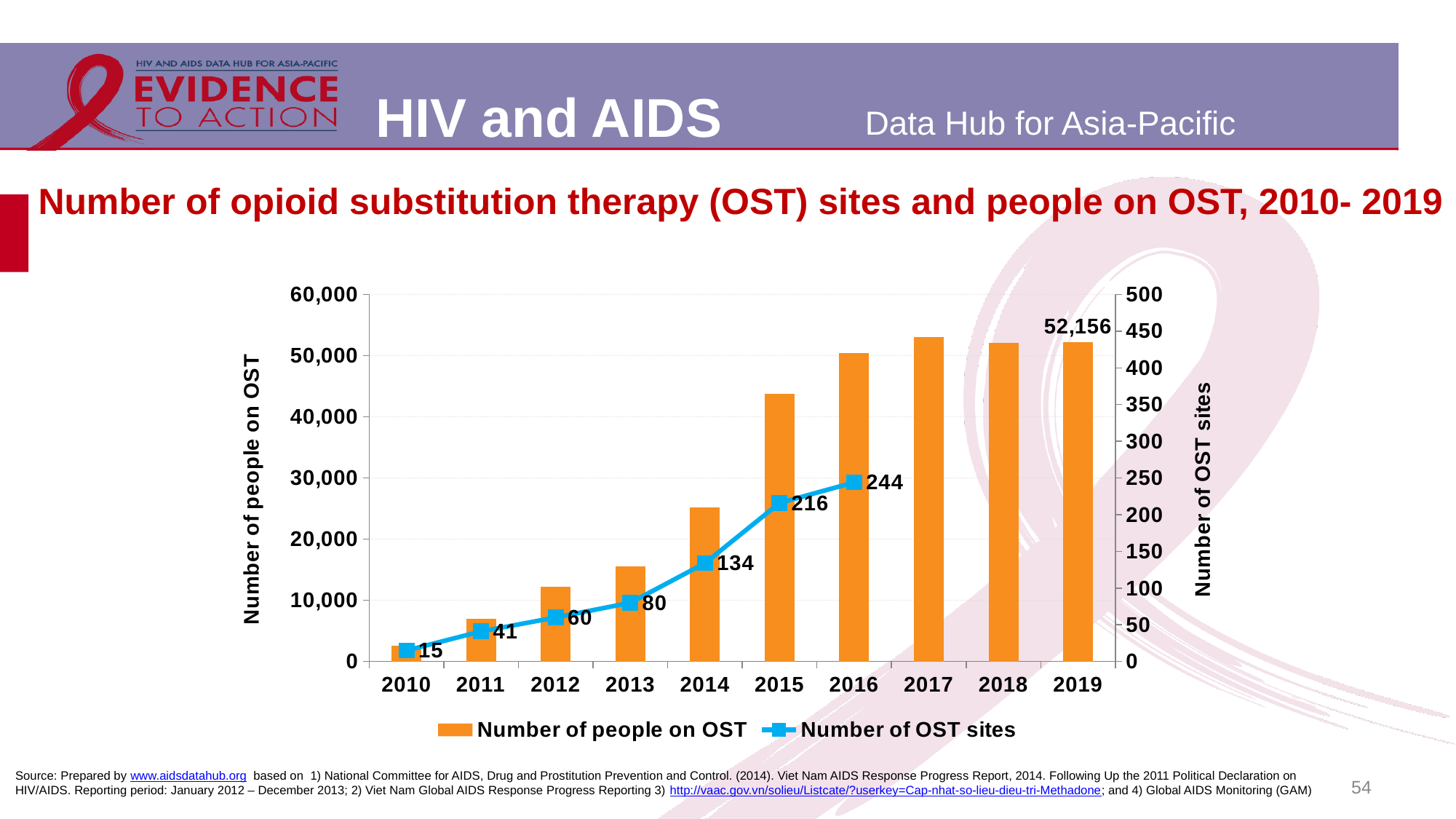
What is the number of people on OST in 2019? 52,156 Is the number of people on OST in 2013 greater or less than 20,000? less Is the number of people on OST in 2015 greater or less than 40,000? greater How many years are shown on the x axis? 10 What is the number of OST sites in 2010? 15 What is the difference in the number of OST sites between 2013 and 2014? 54 How many series does the legend list? 2 Does the number of OST sites rise or fall from 2010 to 2016? rise By how much did the number of OST sites increase from 2015 to 2016? 28 Which year has the lowest number of OST sites? 2010 How many OST sites were there in 2014? 134 Which year has the highest labelled number of OST sites? 2016